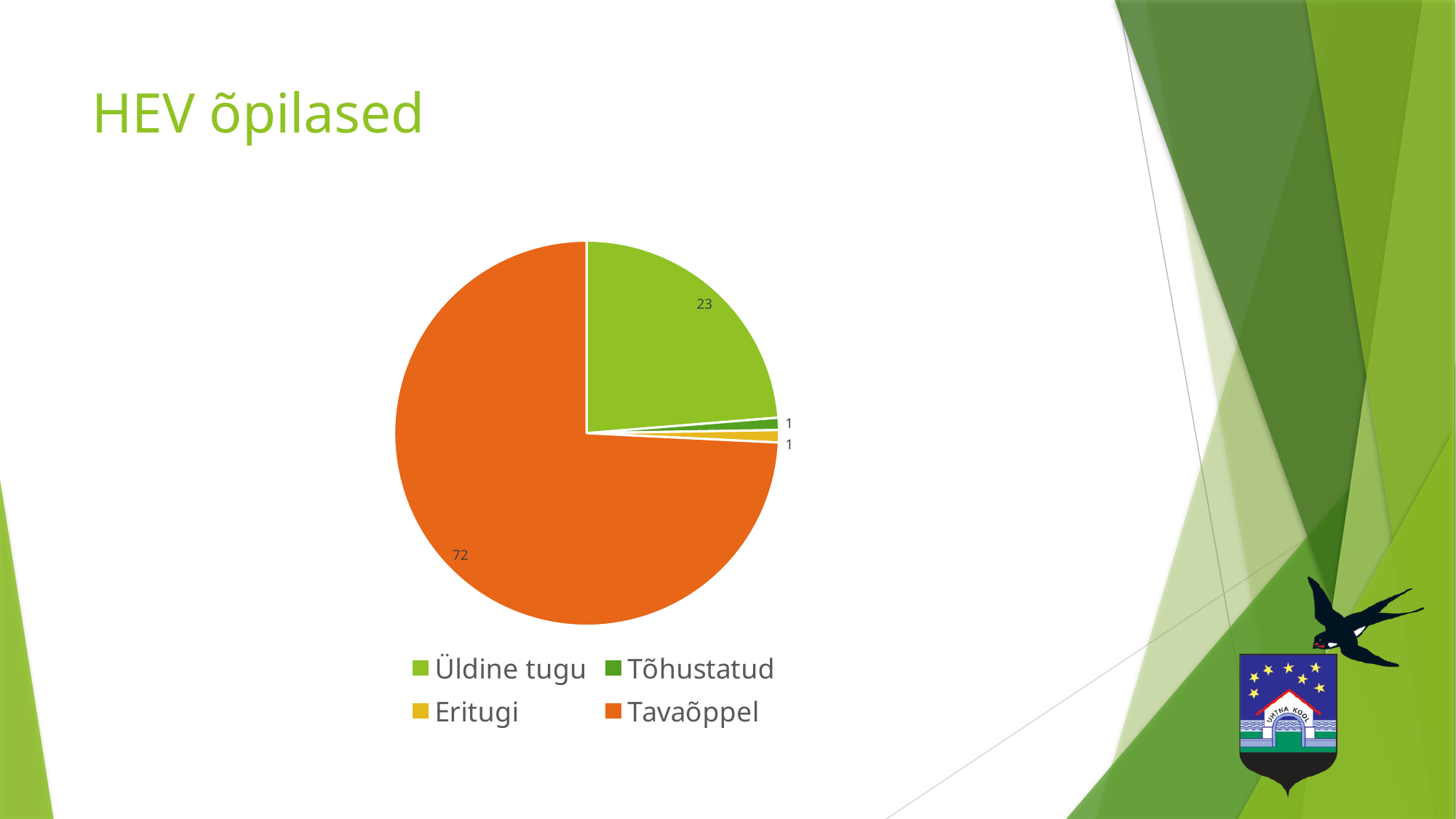
Which category has the largest slice in the pie chart? Tavaõppel Which is larger, the value for Üldine tugu or the value for Tõhustatud? Üldine tugu What is the title of the slide containing the pie chart? HEV õpilased What is the total of all the values shown in the pie chart? 97 What is the value for Üldine tugu in the pie chart? 23 What is the value for Tavaõppel in the pie chart? 72 What is the value for Tõhustatud in the pie chart? 1 What is the value for Eritugi in the pie chart? 1 What is the difference between the values for Tavaõppel and Üldine tugu? 49 What colour is the Tavaõppel slice in the pie chart? orange How many categories does the pie chart show? 4 What type of chart is shown on the slide? pie chart